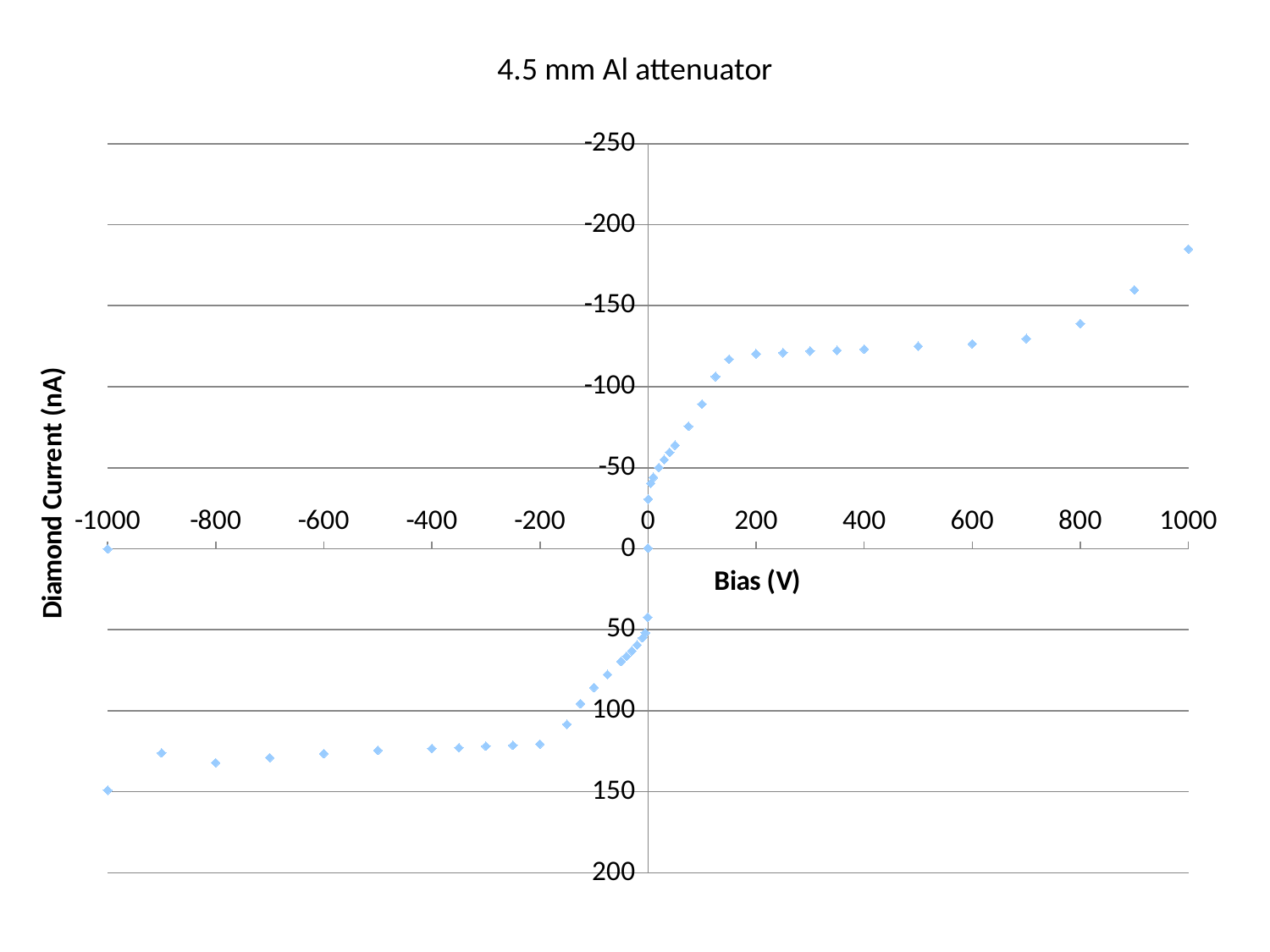
What is the title of the chart? 4.5 mm Al attenuator Does the Diamond Current rise or fall as the Bias increases from -1000 V to 1000 V? fall What is the label of the x axis? Bias (V) At which bias value is the Diamond Current lowest (most negative)? 1000 Is the Diamond Current at a bias of -600 V greater or less than 100 nA? greater Is the Diamond Current at a bias of -200 V greater or less than 100 nA? greater Is the Diamond Current at a bias of 600 V greater or less than -100 nA? less What kind of chart is shown on the slide? scatter chart